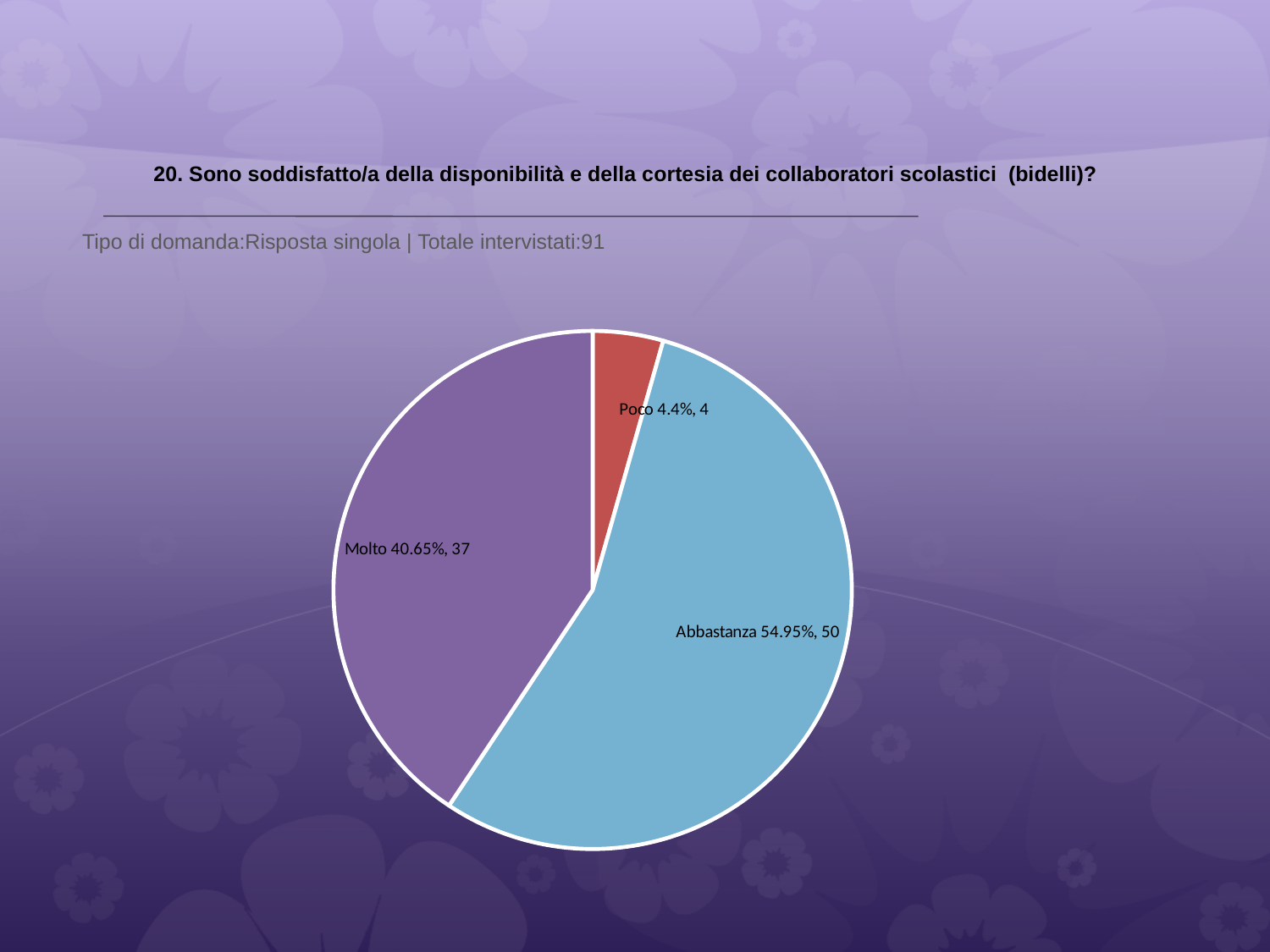
What percentage share does the Molto slice have? 40.65% Which category has the smallest slice? Poco How many slices does the pie chart have? 3 What percentage share does the Abbastanza slice have? 54.95% What kind of chart is shown on the slide? pie chart Which slice is larger, Molto or Poco? Molto How many respondents answered Molto? 37 What percentage share does the Poco slice have? 4.4% Which category has the largest slice? Abbastanza What is the difference in respondent count between Abbastanza and Molto? 13 How many respondents answered Abbastanza? 50 How many respondents answered Poco? 4